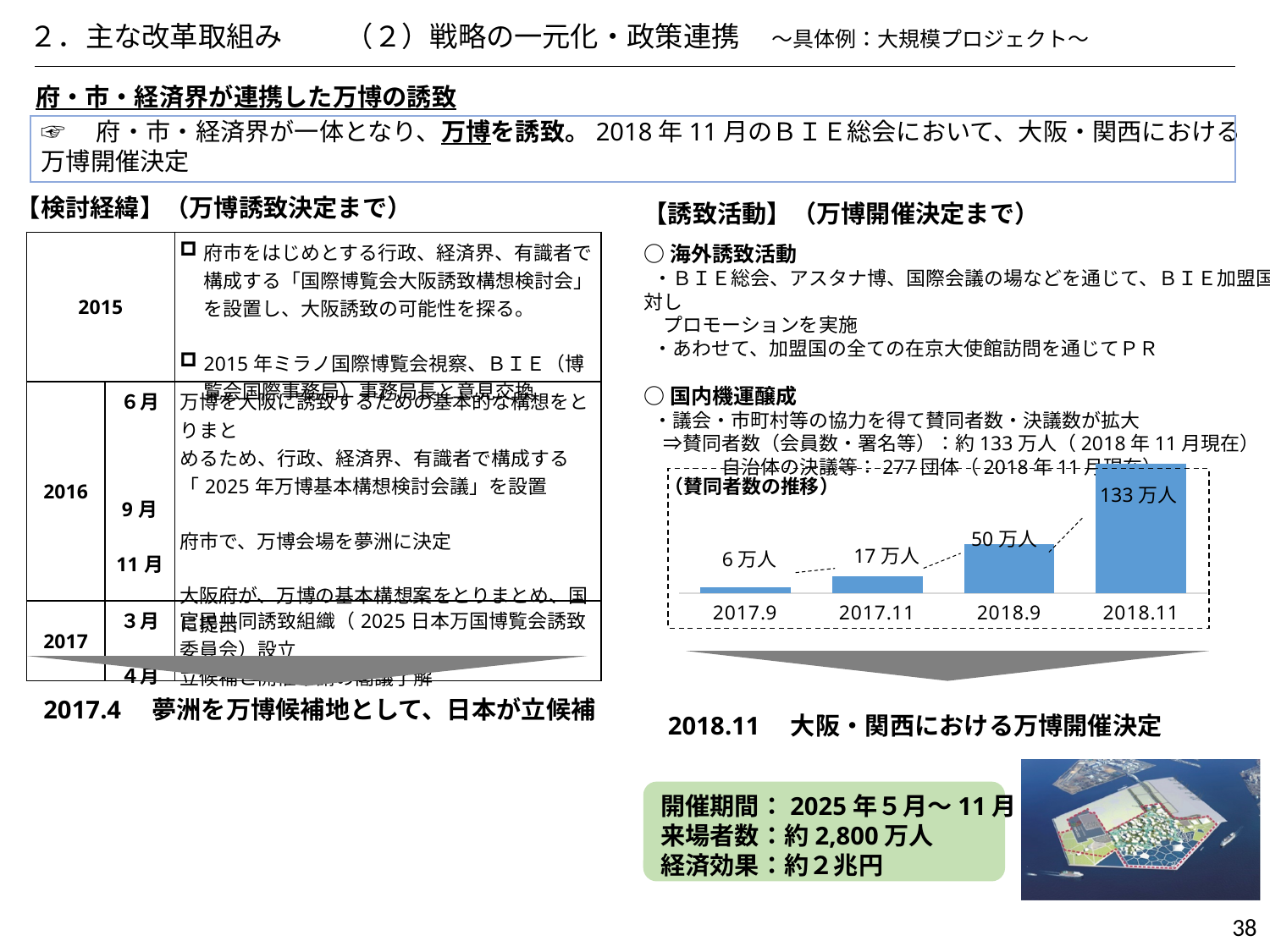
What is the value for 2018.11 in the 賛同者数の推移 chart? 133万人 Do the values in the 賛同者数の推移 chart rise or fall from 2017.9 to 2018.11? rise In the 賛同者数の推移 chart, which is larger, the value for 2018.9 or the value for 2017.11? 2018.9 Which period has the highest value in the 賛同者数の推移 chart? 2018.11 What is the value for 2018.9 in the 賛同者数の推移 chart? 50万人 Which period has the lowest value in the 賛同者数の推移 chart? 2017.9 How many periods are shown on the x axis of the 賛同者数の推移 chart? 4 In the 賛同者数の推移 chart, what is the difference between the values for 2018.11 and 2018.9? 83万人 In the 賛同者数の推移 chart, what is the difference between the values for 2017.11 and 2017.9? 11万人 What kind of chart is the 賛同者数の推移 chart? bar chart What is the value for 2017.11 in the 賛同者数の推移 chart? 17万人 What is the value for 2017.9 in the 賛同者数の推移 chart? 6万人